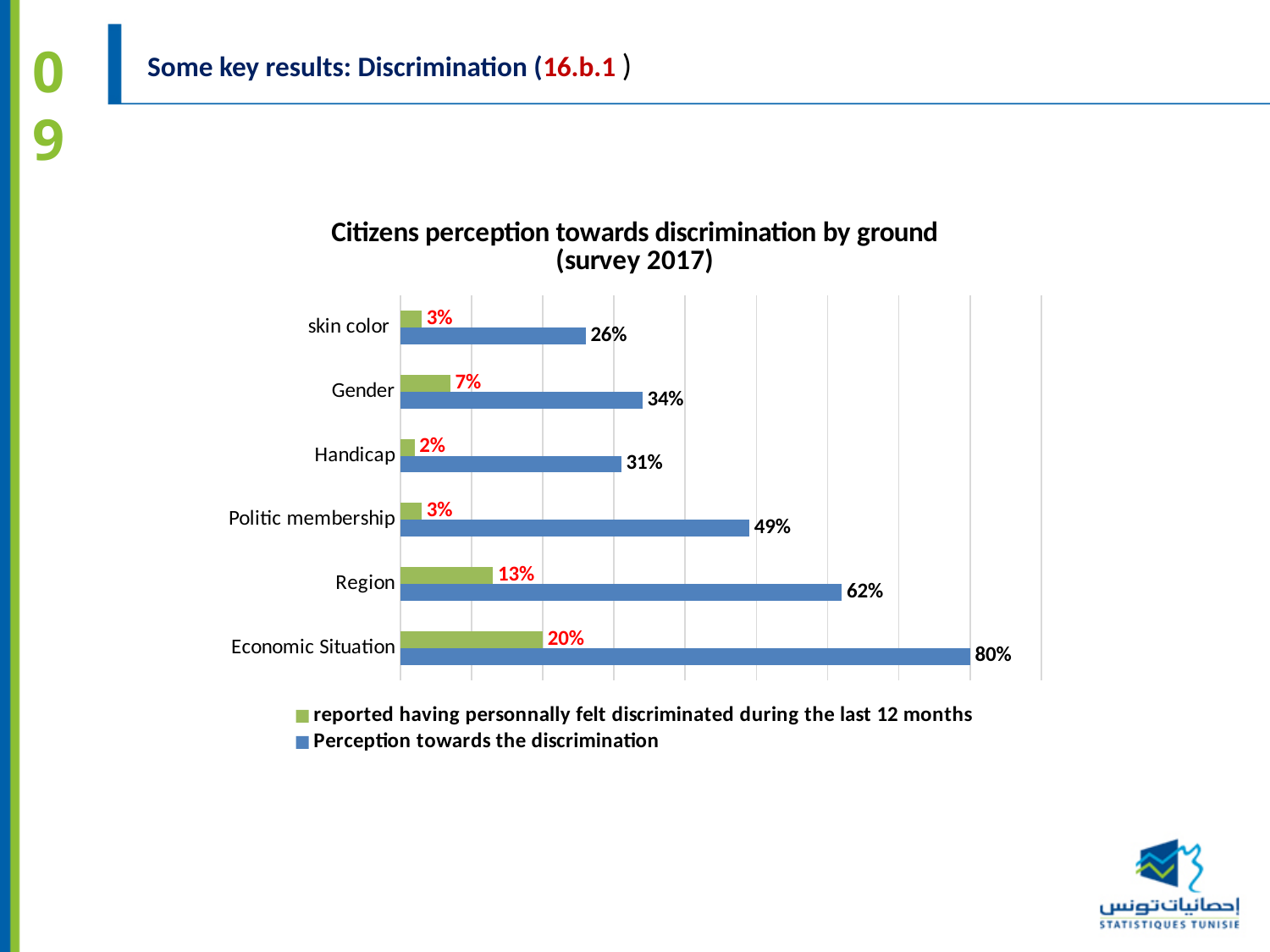
What is the value for Economic Situation in the 'Perception towards the discrimination' series? 80% How many grounds of discrimination are shown on the chart? 6 Which ground has the lowest value for 'reported having personally felt discriminated during the last 12 months'? Handicap What is the title of the chart? Citizens perception towards discrimination by ground (survey 2017) What kind of chart is shown on the slide? Bar chart How many series does the legend list? 2 Which is larger: the 'Perception towards the discrimination' value for Gender or for Handicap? Gender Which colour represents the 'Perception towards the discrimination' series? Blue What is the difference between the 'Perception towards the discrimination' values for Region and Gender? 28% What percentage reported having personally felt discriminated during the last 12 months on the ground of Region? 13% Which ground has the highest 'Perception towards the discrimination' value? Economic Situation What is the 'Perception towards the discrimination' value for Politic membership? 49%